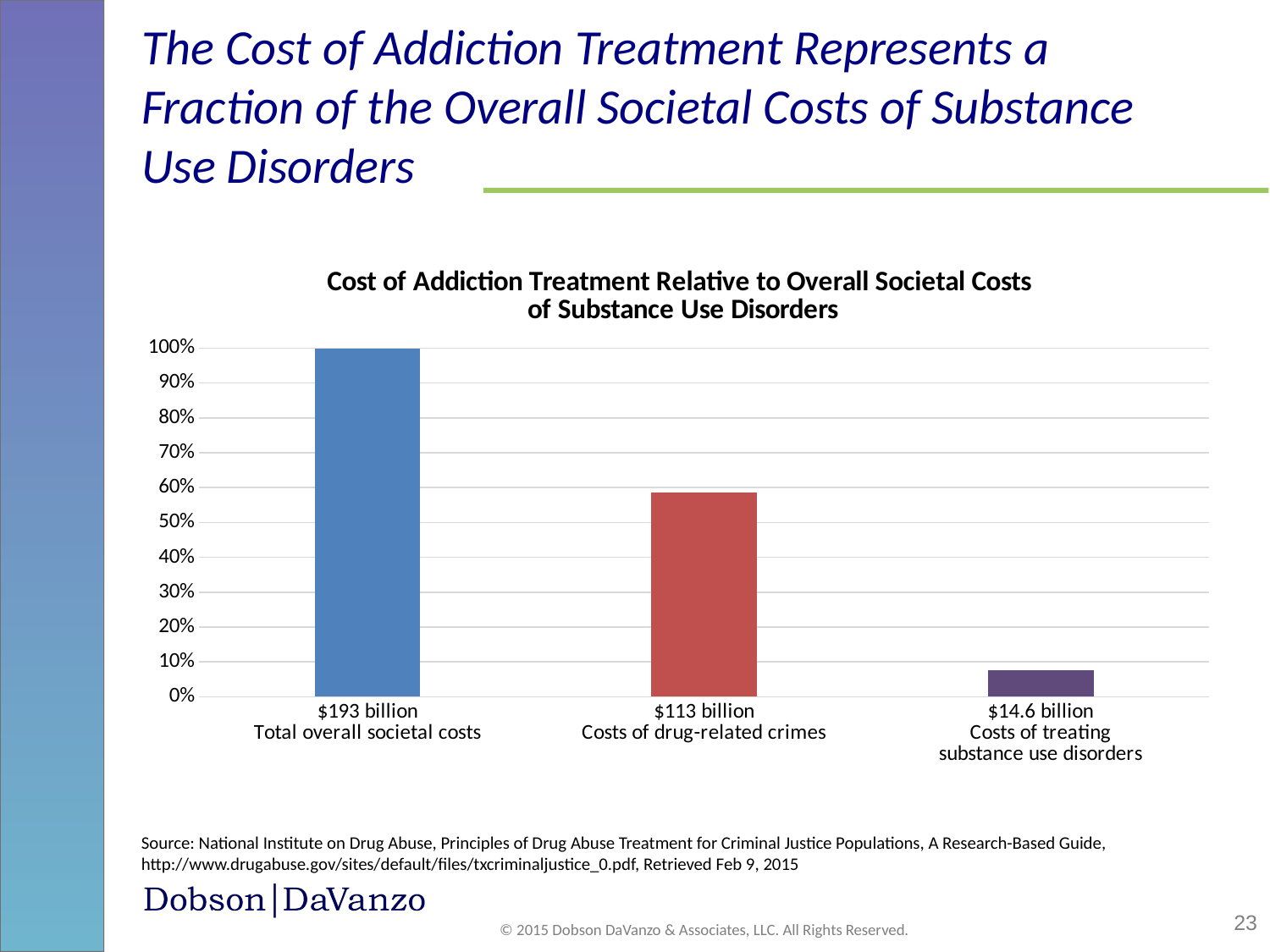
What is the title of the chart? Cost of Addiction Treatment Relative to Overall Societal Costs of Substance Use Disorders How many bars are plotted in the chart? 3 Is the value for Costs of drug-related crimes greater or less than 50%? greater What dollar amount is shown in the axis label for Costs of treating substance use disorders? $14.6 billion Do the bar values rise or fall from left to right across the chart? fall Is the value for Costs of treating substance use disorders greater or less than 10%? less Which category has the lowest value in the chart? Costs of treating substance use disorders Which is larger: the value for Costs of drug-related crimes or the value for Costs of treating substance use disorders? Costs of drug-related crimes Is the value for Costs of drug-related crimes greater or less than 60%? less What kind of chart is shown on the slide? bar chart What percentage does the bar for Total overall societal costs reach? 100% Which category has the highest value in the chart? Total overall societal costs